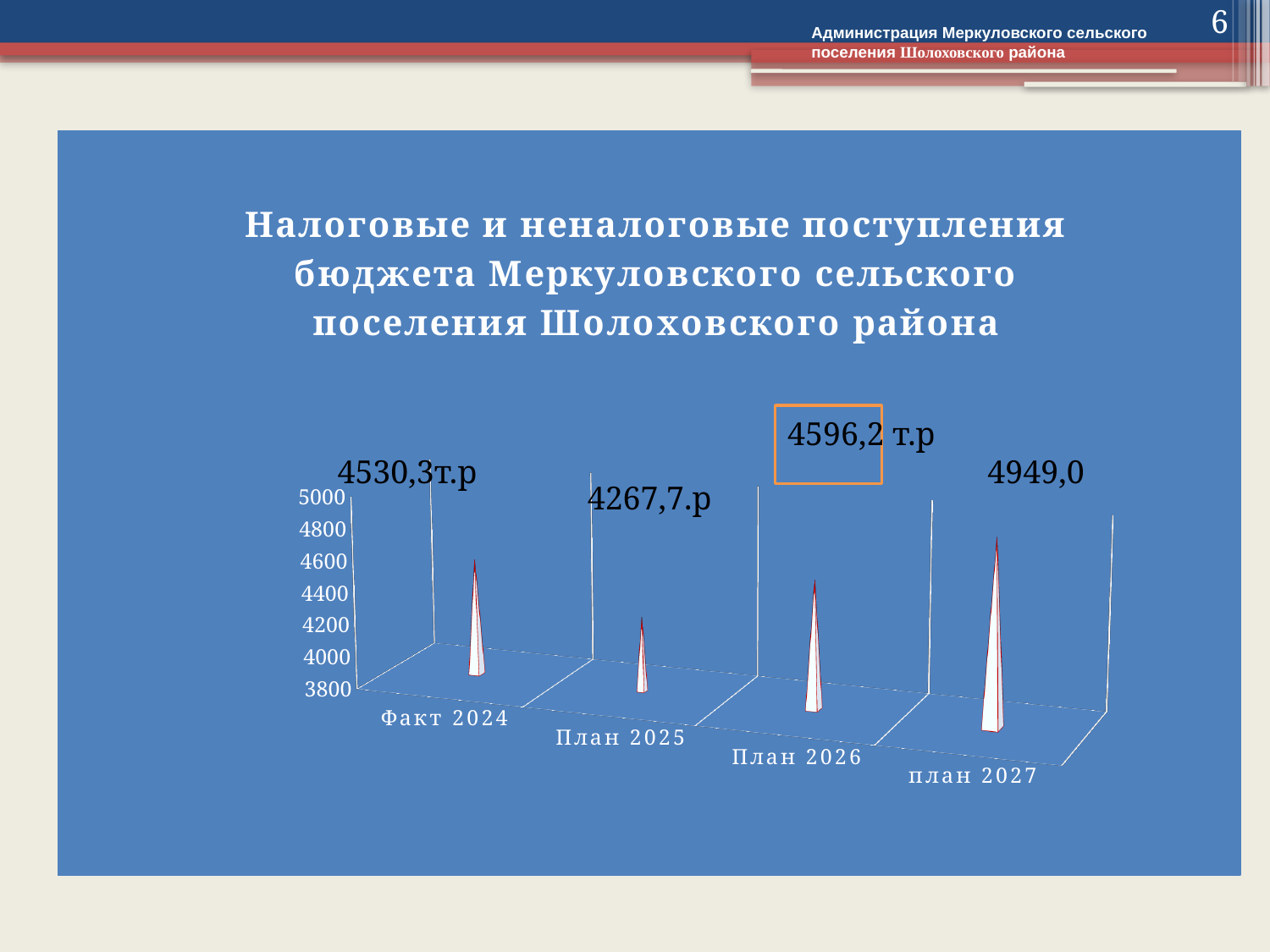
How many categories are shown on the x axis? 4 Which category has the highest value? план 2027 Do the values rise or fall from План 2025 to план 2027? rise What is the difference between the values for План 2026 and План 2025? 328,5 What is the value shown for Факт 2024? 4530,3т.р What is the value shown for План 2025? 4267,7.р What is the value shown for план 2027? 4949,0 What is the difference between the values for план 2027 and Факт 2024? 418,7 Which is larger, the value for Факт 2024 or the value for План 2026? План 2026 Which category has the lowest value? План 2025 What is the value shown for План 2026? 4596,2 т.р What kind of chart is shown on the slide? bar chart